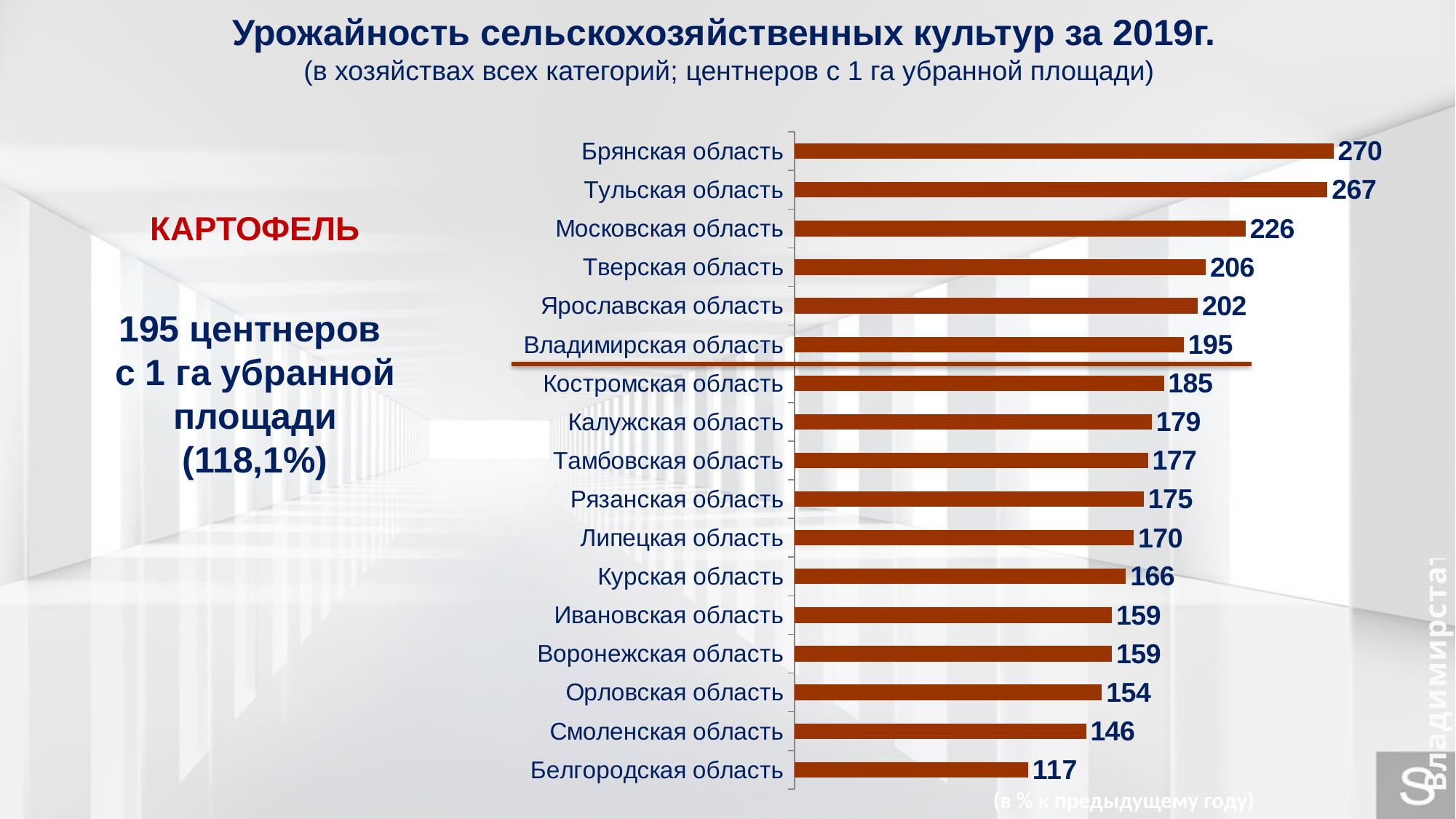
Which has a larger value, Костромская область or Калужская область? Костромская область What value is shown for Смоленская область? 146 What is the potato yield value shown for Владимирская область? 195 What type of chart is shown on the slide? Bar chart What is the difference between the values for Брянская область and Тульская область? 3 Which has a larger value, Тверская область or Ярославская область? Тверская область How many regions are shown on the chart? 17 Which crop does the chart on the slide refer to? Картофель Which region has the highest value on the chart? Брянская область Which region has the lowest value on the chart? Белгородская область What is the difference between the values for Владимирская область and Белгородская область? 78 What value is shown for Московская область? 226